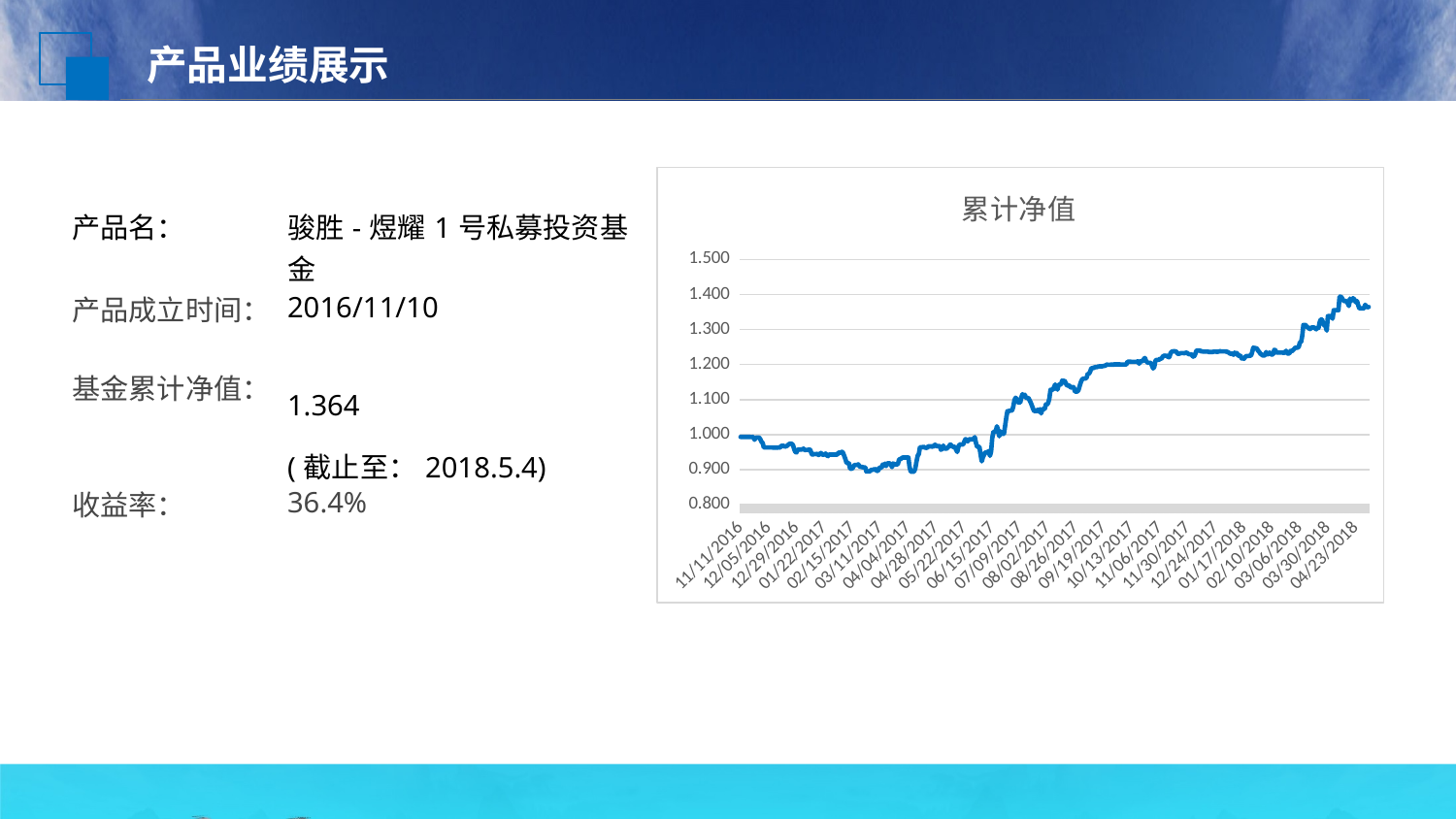
Does the line fall or rise between 11/11/2016 and 03/11/2017? fall Is the value for 02/15/2017 greater or less than 1.000? less Is the value for 09/19/2017 greater or less than 1.100? greater What is the last date label on the x axis of the chart? 04/23/2018 Which is larger, the value for 11/11/2016 or the value for 04/23/2018? 04/23/2018 Is the value for 03/30/2018 greater or less than 1.300? greater What kind of chart is shown on the slide? line chart Which is larger, the value for 03/11/2017 or the value for 09/19/2017? 09/19/2017 Overall, does the line in the chart rise or fall from 11/11/2016 to 04/23/2018? rise What is the title of the chart? 累计净值